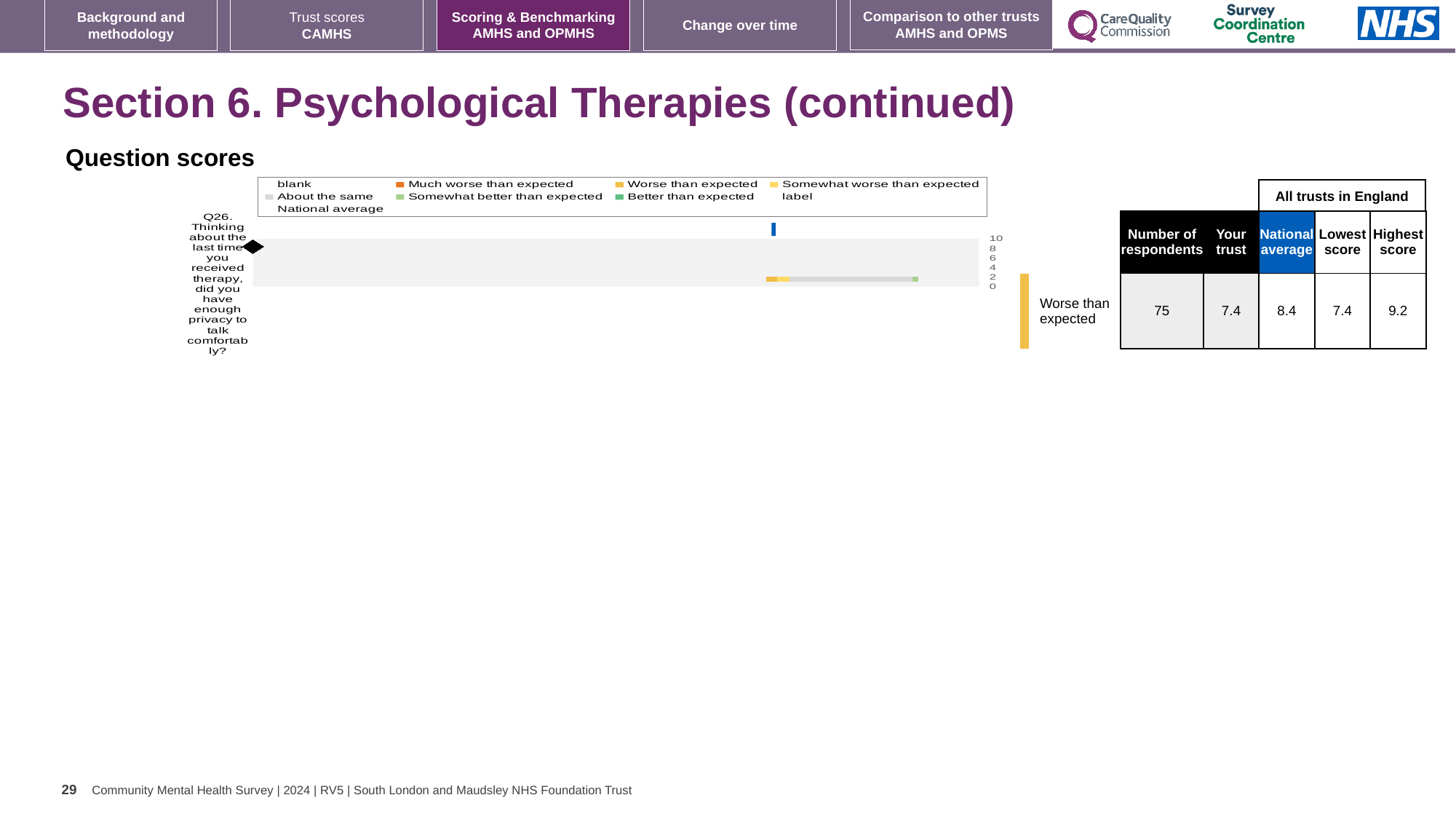
What is the 'Your trust' score for Q26? 7.4 What is the national average score for Q26? 8.4 What benchmark category is shown for Q26 on the chart? Worse than expected Which is larger for Q26, the 'Your trust' score or the national average? national average What is the difference between the national average and the 'Your trust' score for Q26? 1.0 What kind of chart is shown under 'Question scores'? bar chart What colour does the legend use for 'Much worse than expected'? orange How many survey questions are plotted on the chart? 1 What is the highest tick value shown on the chart's score axis? 10 Which question number is plotted on the chart? Q26 How many respondents answered Q26? 75 What is the highest score among all trusts in England for Q26? 9.2